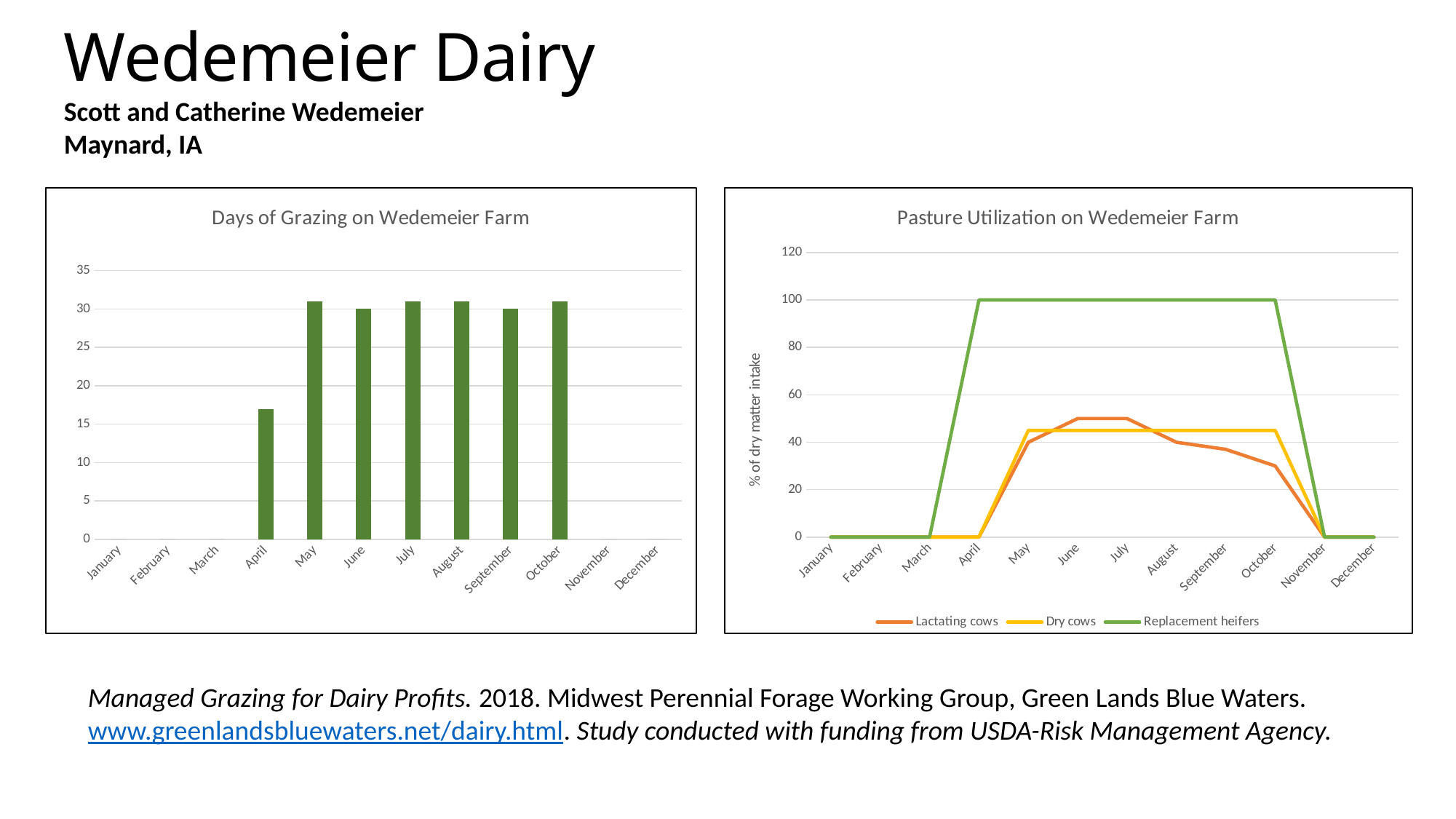
What kind of chart is the 'Days of Grazing on Wedemeier Farm' chart? bar chart In the 'Pasture Utilization on Wedemeier Farm' chart, what is the label on the y axis? % of dry matter intake In the 'Days of Grazing on Wedemeier Farm' chart, is the value for May greater or less than 25? greater In the 'Days of Grazing on Wedemeier Farm' chart, how many months are shown on the x axis? 12 In the 'Pasture Utilization on Wedemeier Farm' chart, what is the value for Replacement heifers in January? 0 In the 'Pasture Utilization on Wedemeier Farm' chart, how many series does the legend list? 3 In the 'Days of Grazing on Wedemeier Farm' chart, which month has the larger value, April or May? May In the 'Days of Grazing on Wedemeier Farm' chart, is the value for April greater or less than 20? less What kind of chart is the 'Pasture Utilization on Wedemeier Farm' chart? line chart In the 'Pasture Utilization on Wedemeier Farm' chart, is the value for Lactating cows in June greater or less than 40? greater In the 'Pasture Utilization on Wedemeier Farm' chart, what is the value for Replacement heifers in June? 100 In the 'Pasture Utilization on Wedemeier Farm' chart, which series has the larger value in June, Replacement heifers or Lactating cows? Replacement heifers